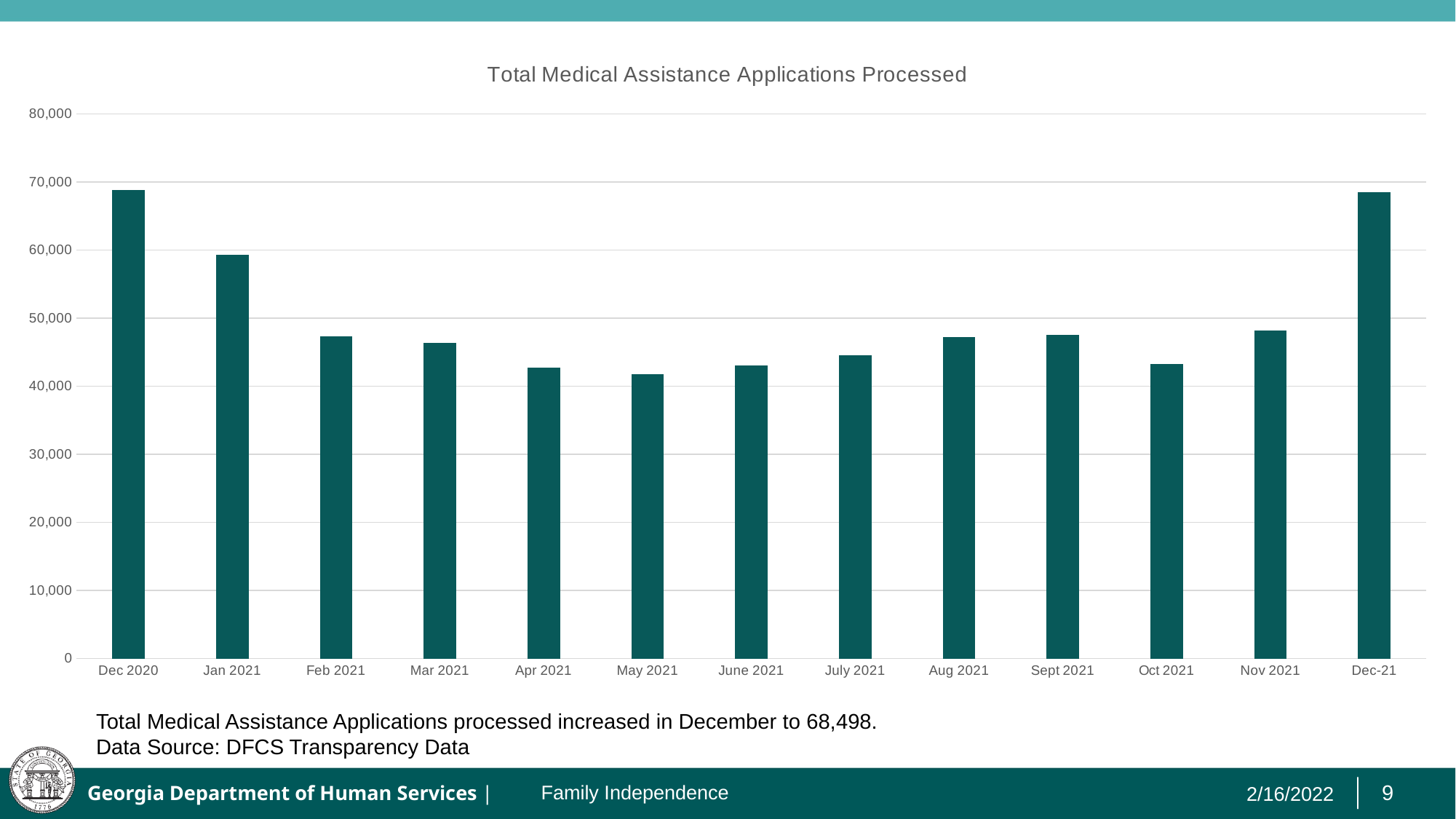
What is the title of the chart? Total Medical Assistance Applications Processed Is the value for Feb 2021 greater or less than 50,000? less Is the value for Dec 2020 greater or less than 60,000? greater Which month has the lowest value in the chart? May 2021 How many months are shown on the x axis of the chart? 13 Is the value for May 2021 greater or less than 40,000? greater Which is larger, the value for Oct 2021 or the value for Nov 2021? Nov 2021 Which is larger, the value for Jan 2021 or the value for Feb 2021? Jan 2021 What is the value for Dec-21 in the chart? 68,498 Do the values rise or fall from Dec 2020 to May 2021? fall What type of chart is shown on the slide? Bar chart